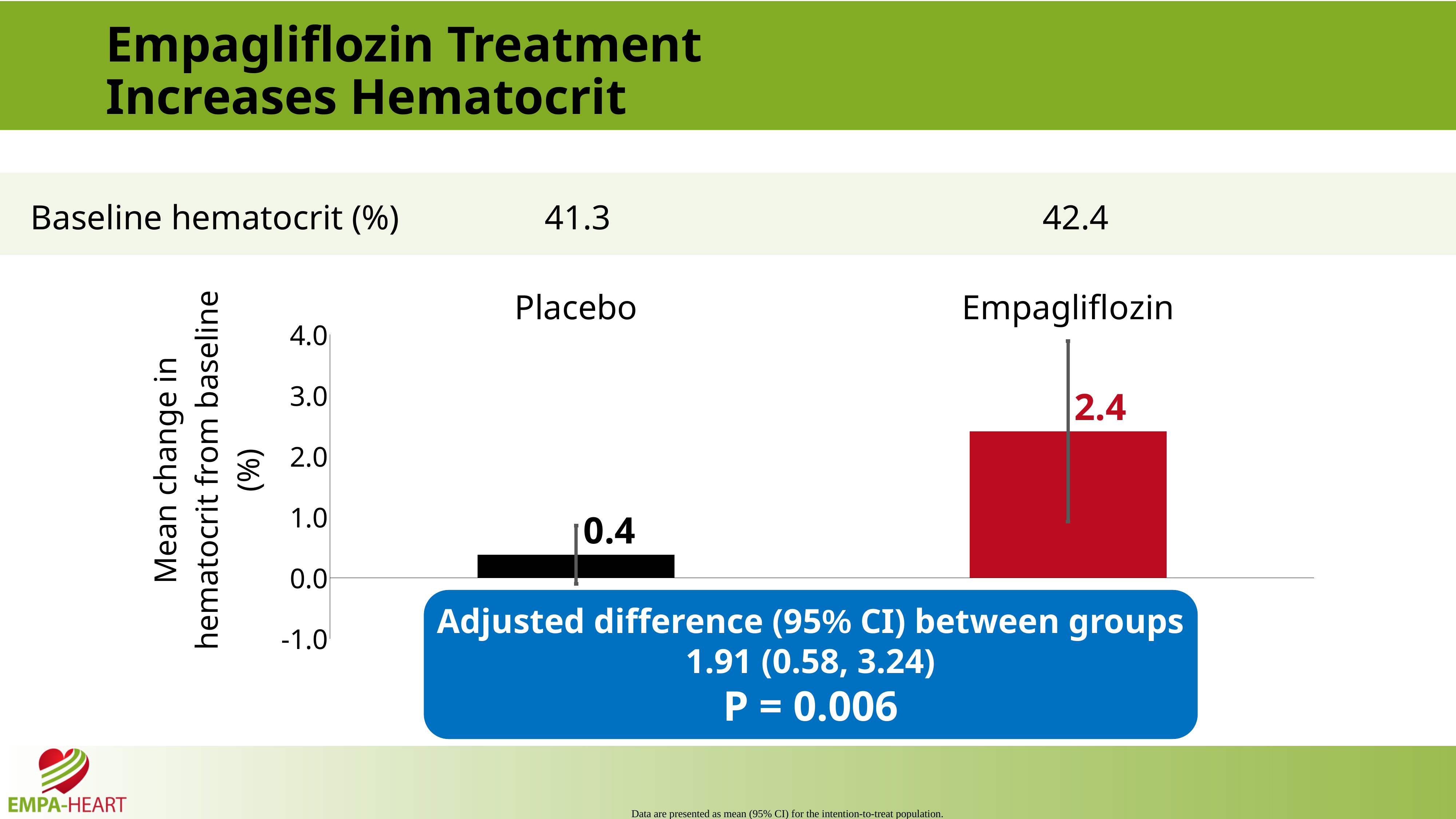
What is the difference between the Empagliflozin and Placebo mean changes in hematocrit shown on the bars? 2.0 Is the mean change in hematocrit for Placebo greater or less than 1.0? less What is the mean change in hematocrit from baseline for the Empagliflozin group? 2.4 What colour is the Empagliflozin bar? Red Is the mean change in hematocrit for Empagliflozin greater or less than 2.0? greater What type of chart is shown on the slide? Bar chart What is the mean change in hematocrit from baseline for the Placebo group? 0.4 Which group has the lower mean change in hematocrit from baseline? Placebo Which group has the higher mean change in hematocrit from baseline? Empagliflozin How many groups are plotted in the chart? 2 Is the mean change in hematocrit larger for Empagliflozin or for Placebo? Empagliflozin What is the label of the y axis of the chart? Mean change in hematocrit from baseline (%)